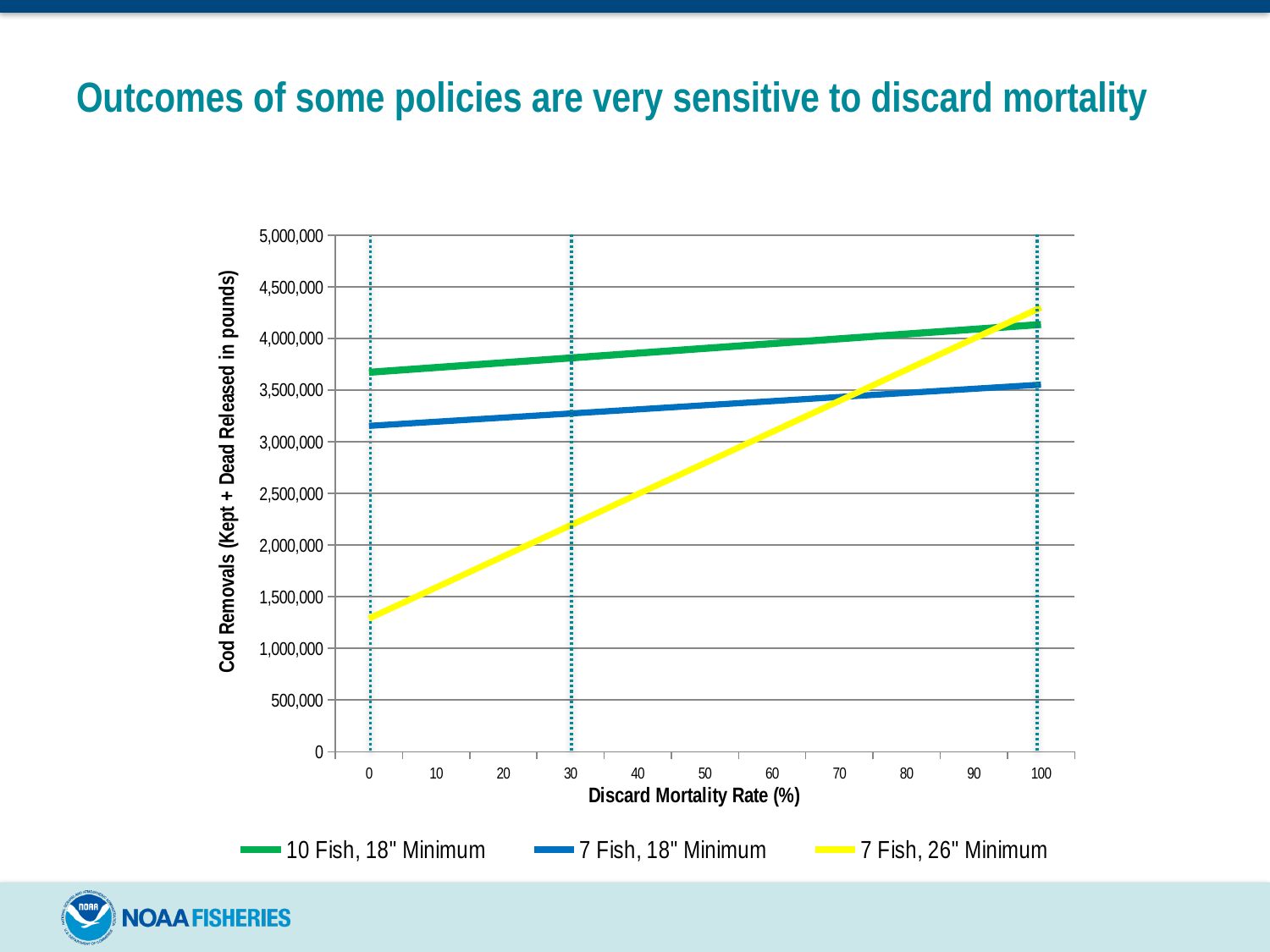
Is the value for the 10 Fish, 18" Minimum series at a discard mortality rate of 100% greater or less than 4,000,000? greater At a discard mortality rate of 30%, which series has larger cod removals: 7 Fish, 18" Minimum or 7 Fish, 26" Minimum? 7 Fish, 18" Minimum Do the cod removals for the 7 Fish, 26" Minimum series rise or fall as the discard mortality rate increases? rise What is the label of the x axis? Discard Mortality Rate (%) Which series has the highest cod removals at a discard mortality rate of 100%? 7 Fish, 26" Minimum How many series does the legend list? 3 Which series has the highest cod removals at a discard mortality rate of 0%? 10 Fish, 18" Minimum Is the value for the 7 Fish, 26" Minimum series at a discard mortality rate of 0% greater or less than 1,500,000? less Which series has the lowest cod removals at a discard mortality rate of 0%? 7 Fish, 26" Minimum What kind of chart is shown on the slide? line chart Is the value for the 7 Fish, 18" Minimum series at a discard mortality rate of 30% greater or less than 3,500,000? less What colour is the line for the 7 Fish, 26" Minimum series? yellow